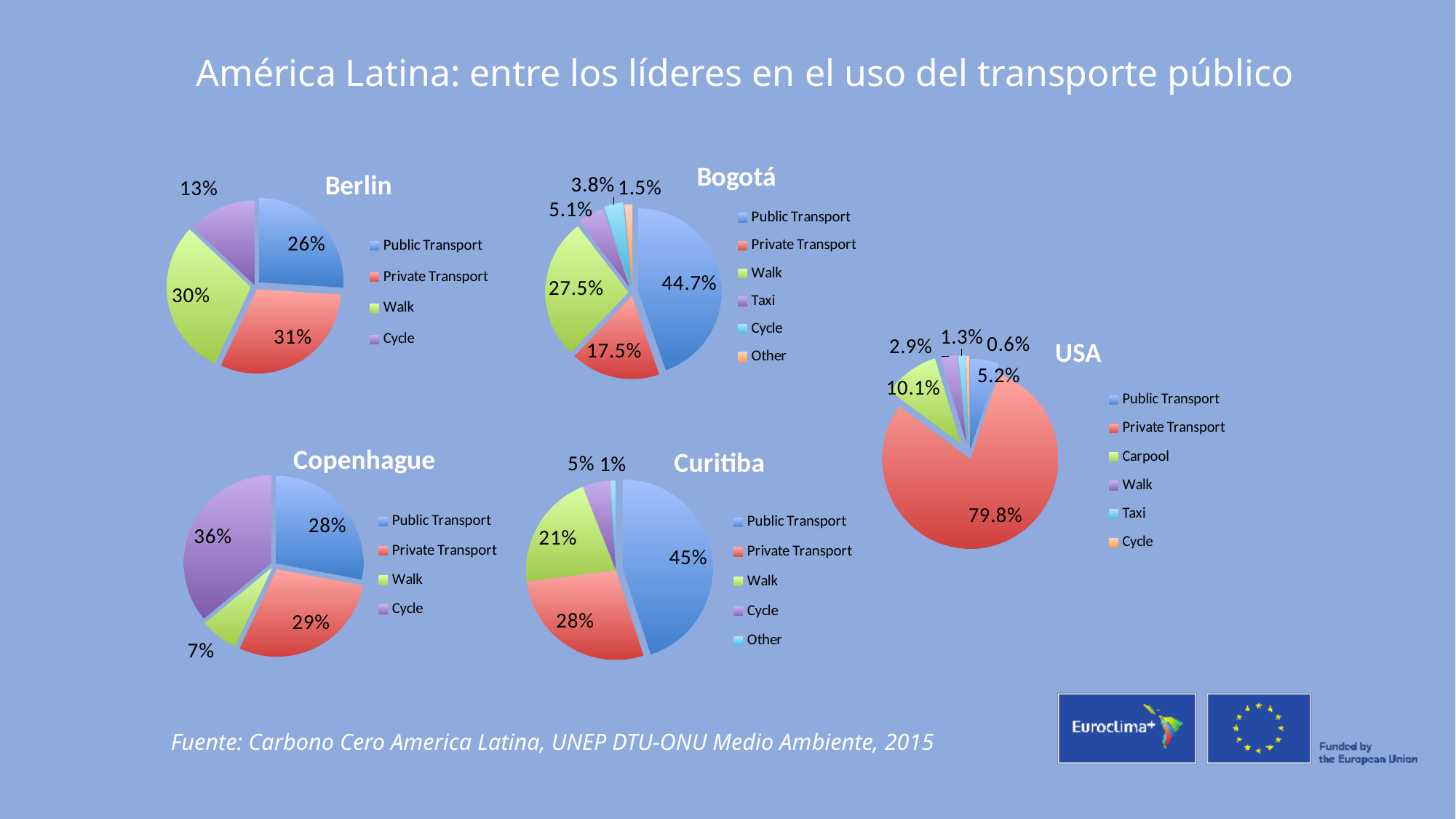
In the Copenhague chart, which category has the largest share? Cycle In the Bogotá chart, what is the difference between the Public Transport and Private Transport shares? 27.2% In the Curitiba chart, which is larger: Public Transport or Private Transport? Public Transport What kind of chart is used for Berlin? Pie chart In the USA chart, what share is Carpool? 10.1% In the Curitiba chart, which category has the smallest share? Other In the USA chart, what share is Private Transport? 79.8% In the Bogotá chart, what share is Walk? 27.5% How many categories does the legend of the USA chart list? 6 In the Berlin chart, what share is Public Transport? 26% How many pie charts are shown on the slide? 5 How many slices does the Copenhague chart have? 4